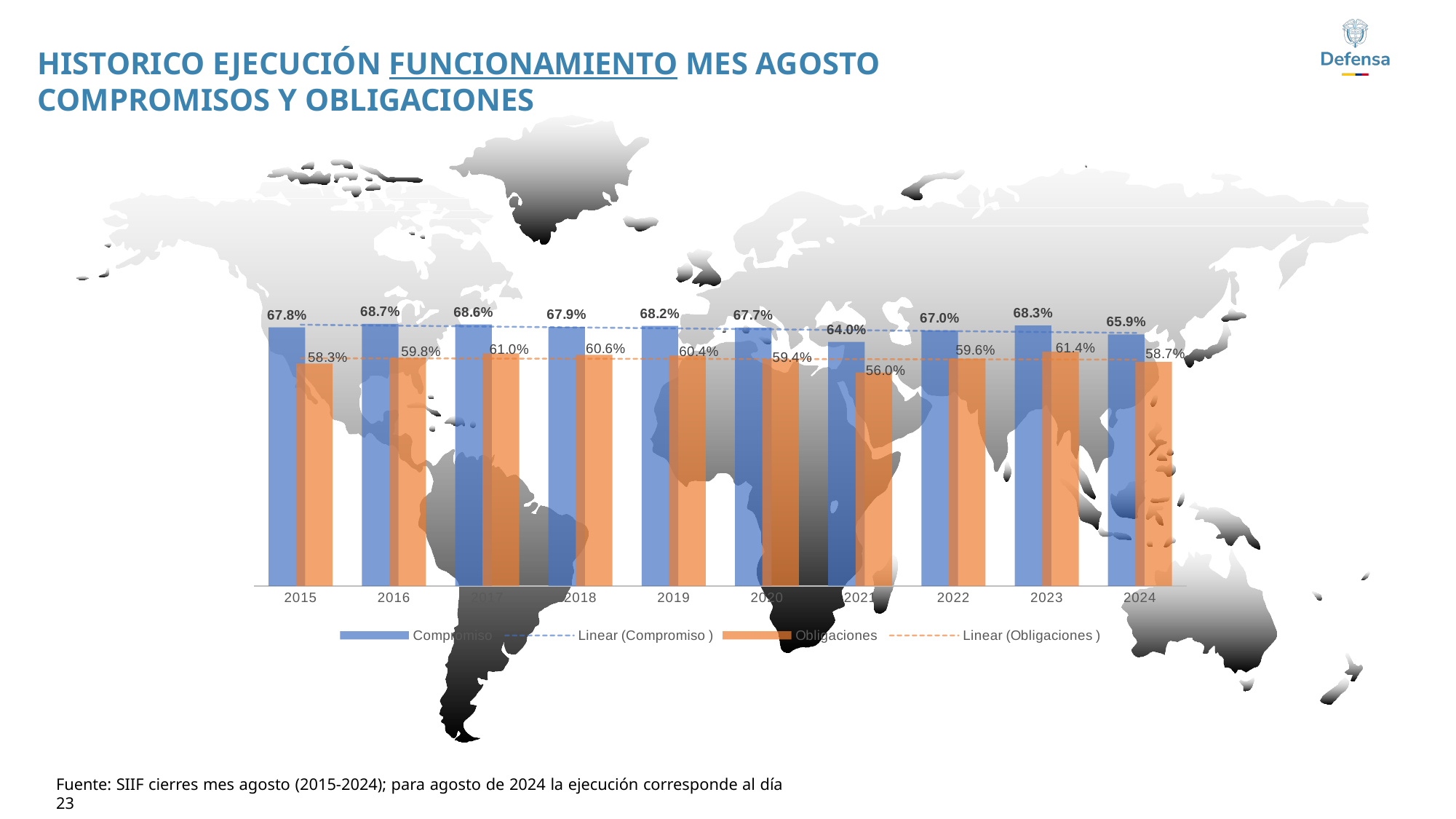
How many entries does the legend list? 4 What kind of chart is shown on the slide? Bar chart Which is larger, the Compromiso value for 2019 or the Compromiso value for 2024? 2019 How many years are shown on the x axis? 10 What is the difference between the Compromiso and Obligaciones values in 2024? 7.2 percentage points Which year has the highest Obligaciones value? 2023 What is the difference between the Compromiso and Obligaciones values in 2015? 9.5 percentage points Which year has the lowest Obligaciones value? 2021 What is the Obligaciones value for 2021? 56.0% Which year has the lowest Compromiso value? 2021 What is the Compromiso value for 2016? 68.7% What is the Obligaciones value for 2023? 61.4%